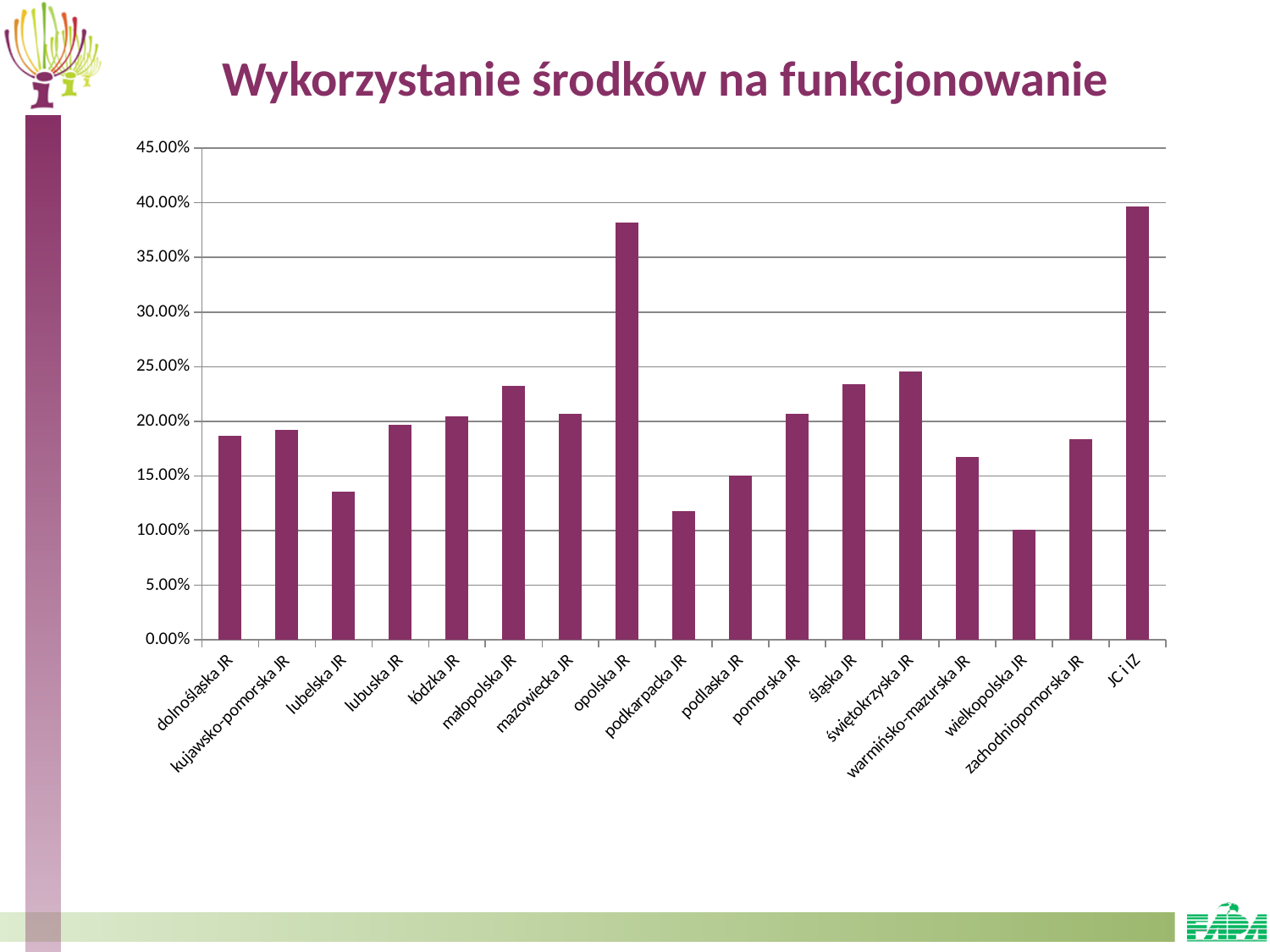
Which has a larger value, małopolska JR or mazowiecka JR? małopolska JR What kind of chart is shown on the slide? bar chart Which category has the lowest value in the chart? wielkopolska JR Is the value for wielkopolska JR greater or less than 15.00%? less Is the value for JC i IZ greater or less than 35.00%? greater What is the highest value shown on the y axis of the chart? 45.00% How many categories are shown on the x axis of the chart? 17 What is the title of the chart? Wykorzystanie środków na funkcjonowanie Is the value for lubelska JR greater or less than 15.00%? less Which category has the highest value in the chart? JC i IZ